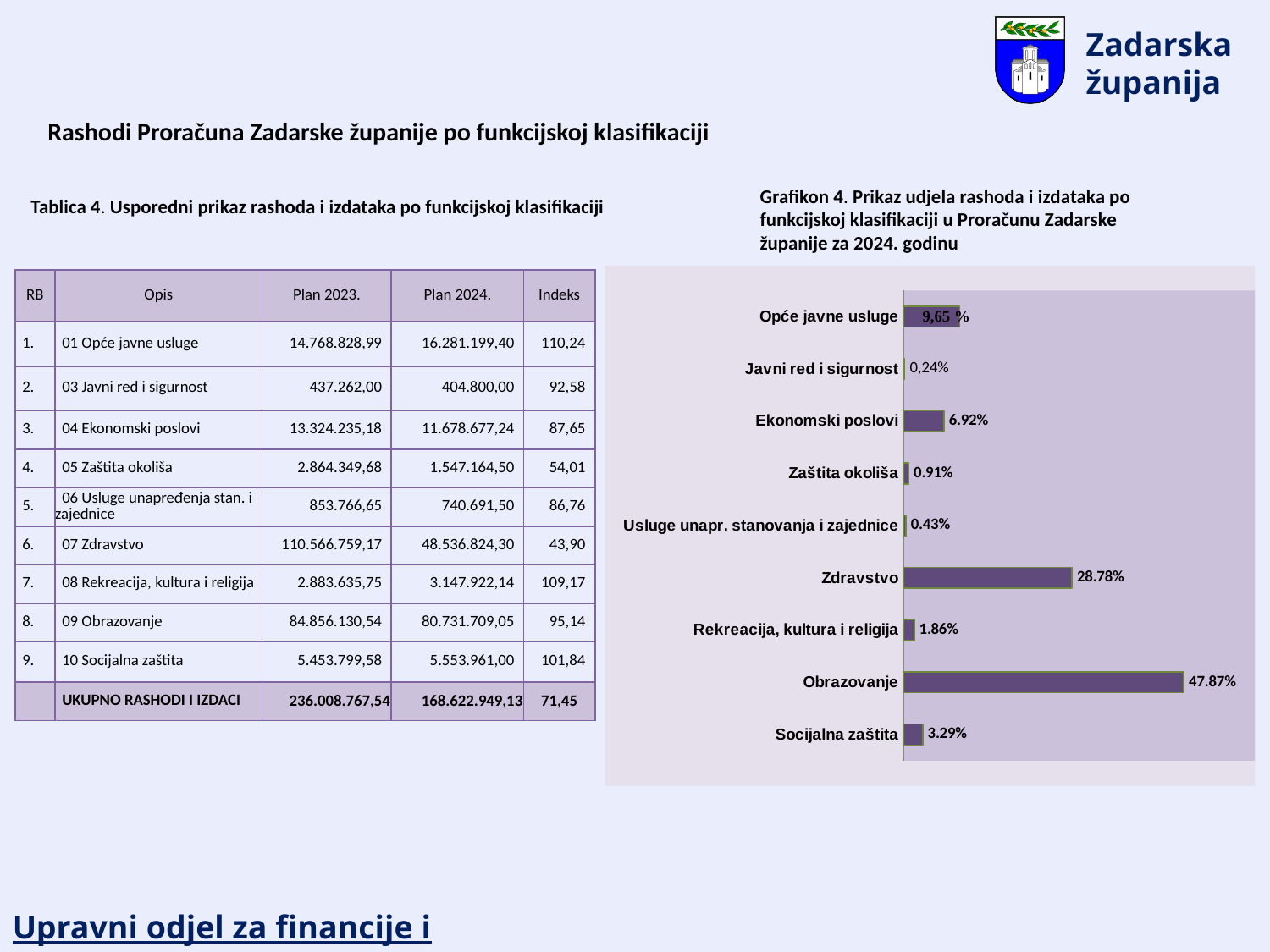
What is the value shown for Usluge unapr. stanovanja i zajednice in the chart? 0.43% What is the difference between the values for Obrazovanje and Zdravstvo? 19.09% What is the value shown for Socijalna zaštita in the chart? 3.29% What is the value shown for Zdravstvo in the chart? 28.78% Which category has the lowest value in the chart? Javni red i sigurnost Which category has the highest value in the chart? Obrazovanje What is the value shown for Ekonomski poslovi in the chart? 6.92% What is the title of the chart? Grafikon 4. Prikaz udjela rashoda i izdataka po funkcijskoj klasifikaciji u Proračunu Zadarske županije za 2024. godinu What kind of chart is shown on the slide? bar chart Which is larger, the value for Ekonomski poslovi or the value for Socijalna zaštita? Ekonomski poslovi How many categories are shown in the chart? 9 What is the value shown for Obrazovanje in the chart? 47.87%